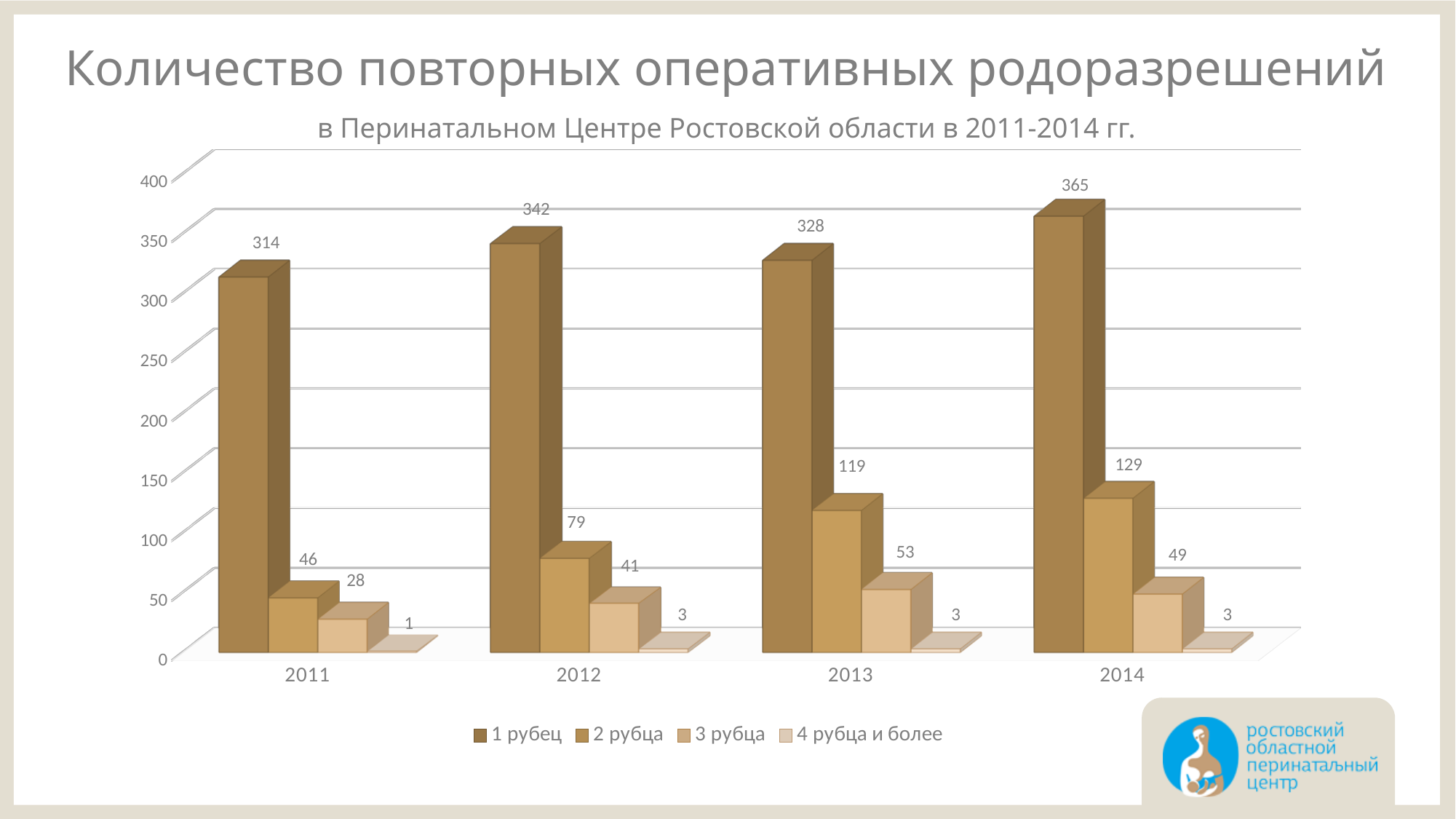
How many series does the legend list? 4 What is the difference between the "1 рубец" values for 2014 and 2011? 51 In which year is the value for "2 рубца" lowest? 2011 What is the value for "2 рубца" in 2012? 79 How many years are shown on the x axis? 4 What is the value for "4 рубца и более" in 2011? 1 What is the value for "3 рубца" in 2013? 53 Does the value for "2 рубца" rise or fall from 2011 to 2014? rise Which is larger: the "3 рубца" value in 2013 or in 2014? 2013 In which year is the value for "1 рубец" highest? 2014 What is the value for "1 рубец" in 2014? 365 What kind of chart is shown on the slide? bar chart